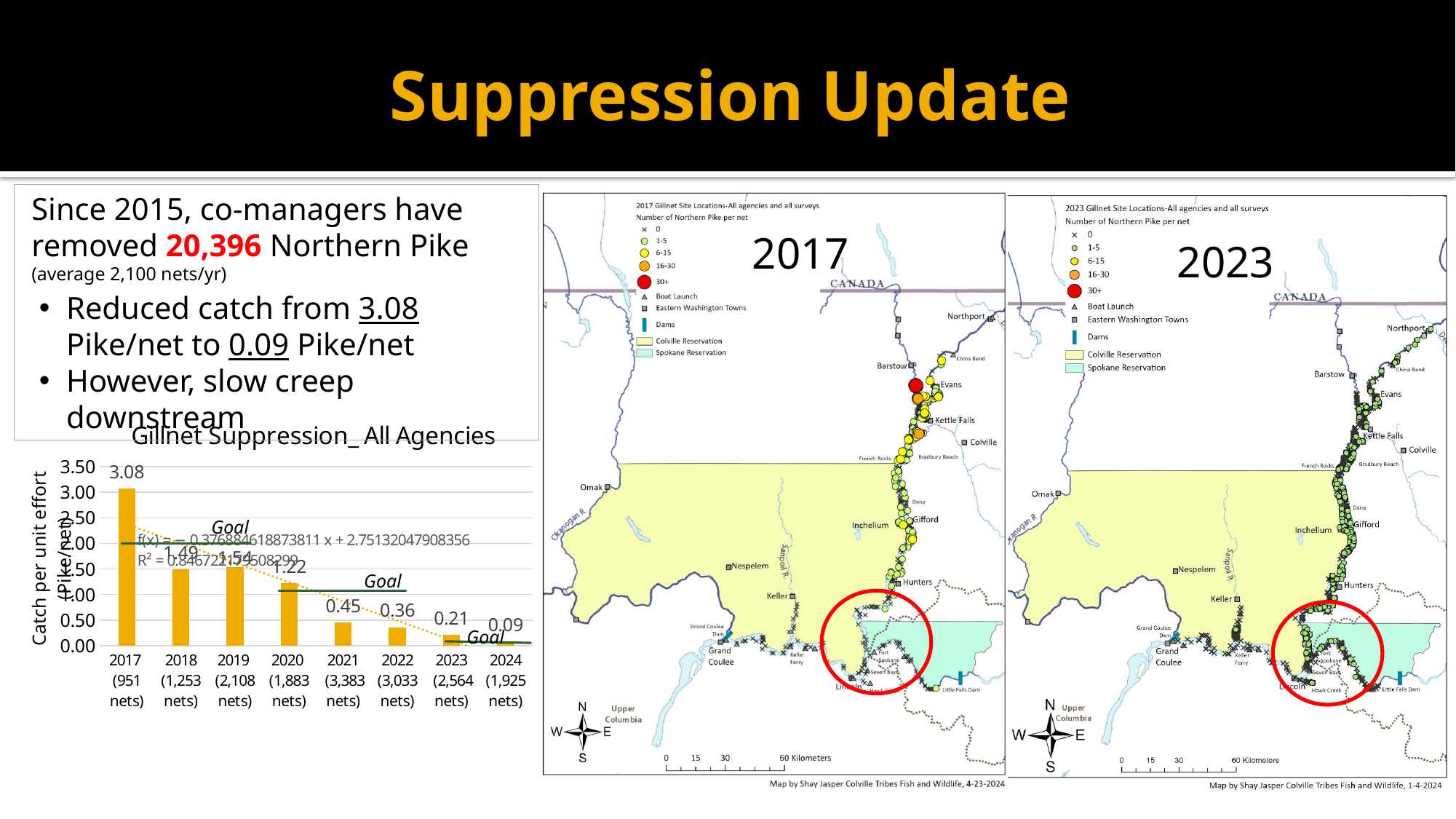
In the Gillnet Suppression_ All Agencies chart, which year has the larger value, 2021 or 2022? 2021 In the Gillnet Suppression_ All Agencies chart, which year has the lowest catch per unit effort? 2024 In the Gillnet Suppression_ All Agencies chart, what is the value for 2023? 0.21 How many years are shown on the x axis of the Gillnet Suppression_ All Agencies chart? 8 In the Gillnet Suppression_ All Agencies chart, what is the catch per unit effort for 2017? 3.08 In the Gillnet Suppression_ All Agencies chart, what is the value for 2020? 1.22 In the Gillnet Suppression_ All Agencies chart, what is the difference between the 2017 and 2024 values? 2.99 In the Gillnet Suppression_ All Agencies chart, do the values generally rise or fall from 2017 to 2024? Fall In the Gillnet Suppression_ All Agencies chart, what is the value for 2021? 0.45 In the Gillnet Suppression_ All Agencies chart, which year has the highest catch per unit effort? 2017 What kind of chart is the Gillnet Suppression_ All Agencies chart? Bar chart In the Gillnet Suppression_ All Agencies chart, what is the catch per unit effort for 2024? 0.09